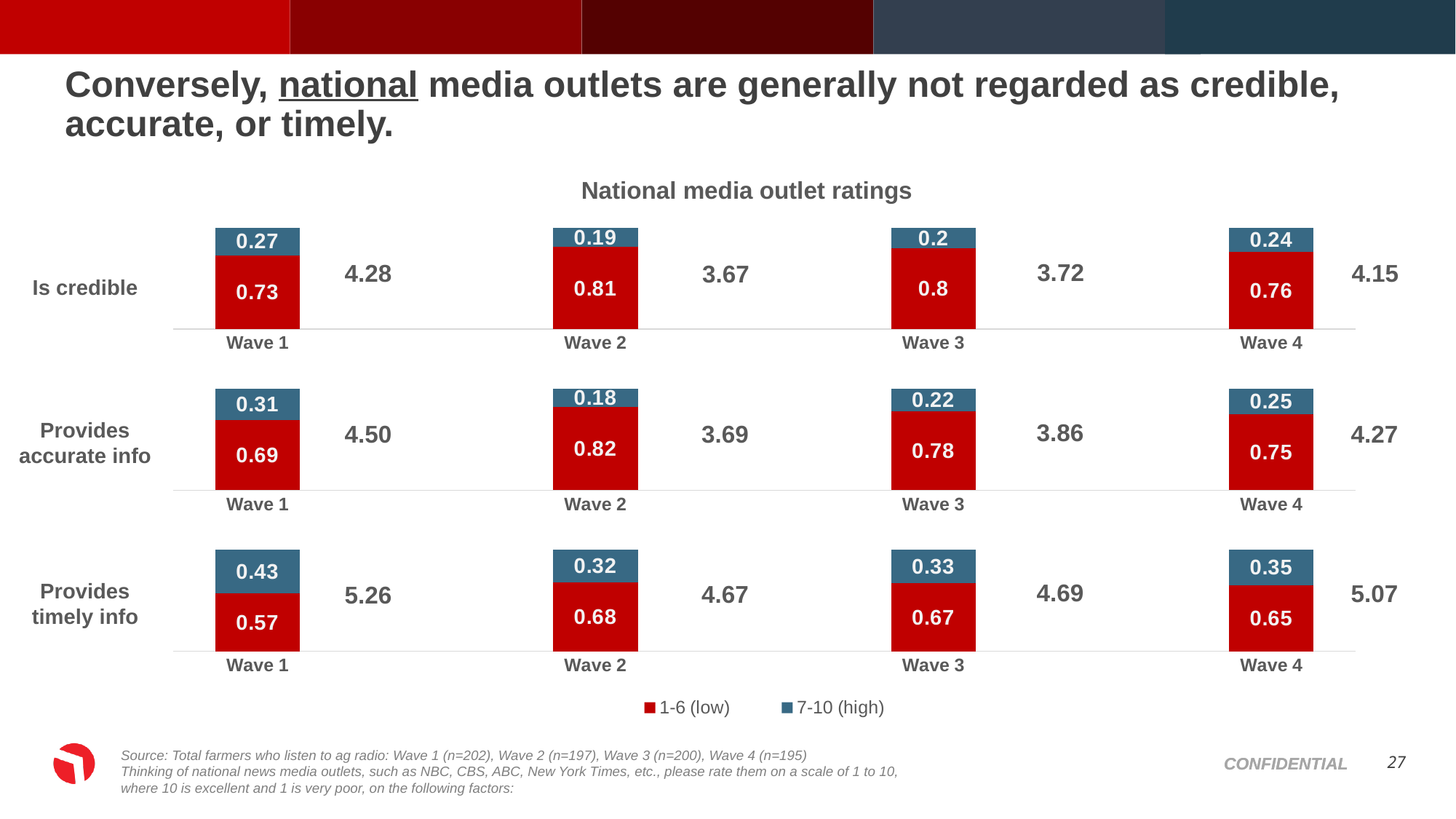
In the 'Is credible' chart, is the 1-6 (low) value larger for Wave 3 or Wave 4? Wave 3 In the 'Provides timely info' chart, what is the value of the 7-10 (high) segment for Wave 1? 0.43 What kind of chart is used for the 'Is credible' ratings? Stacked bar chart How many series does the legend list? 2 In the 'Provides accurate info' chart, what is the value of the 7-10 (high) segment for Wave 3? 0.22 How many waves are shown in the 'Provides accurate info' chart? 4 In the 'Provides accurate info' chart, which wave has the lowest 7-10 (high) value? Wave 2 In the 'Is credible' chart, which wave has the highest 7-10 (high) value? Wave 1 In the 'Provides timely info' chart, what is the total of the stacked bar for Wave 4? 1 What is the title shown above the charts? National media outlet ratings In the 'Is credible' chart, what is the value of the 1-6 (low) segment for Wave 2? 0.81 In the 'Provides timely info' chart, what is the difference between the 1-6 (low) values for Wave 2 and Wave 1? 0.11